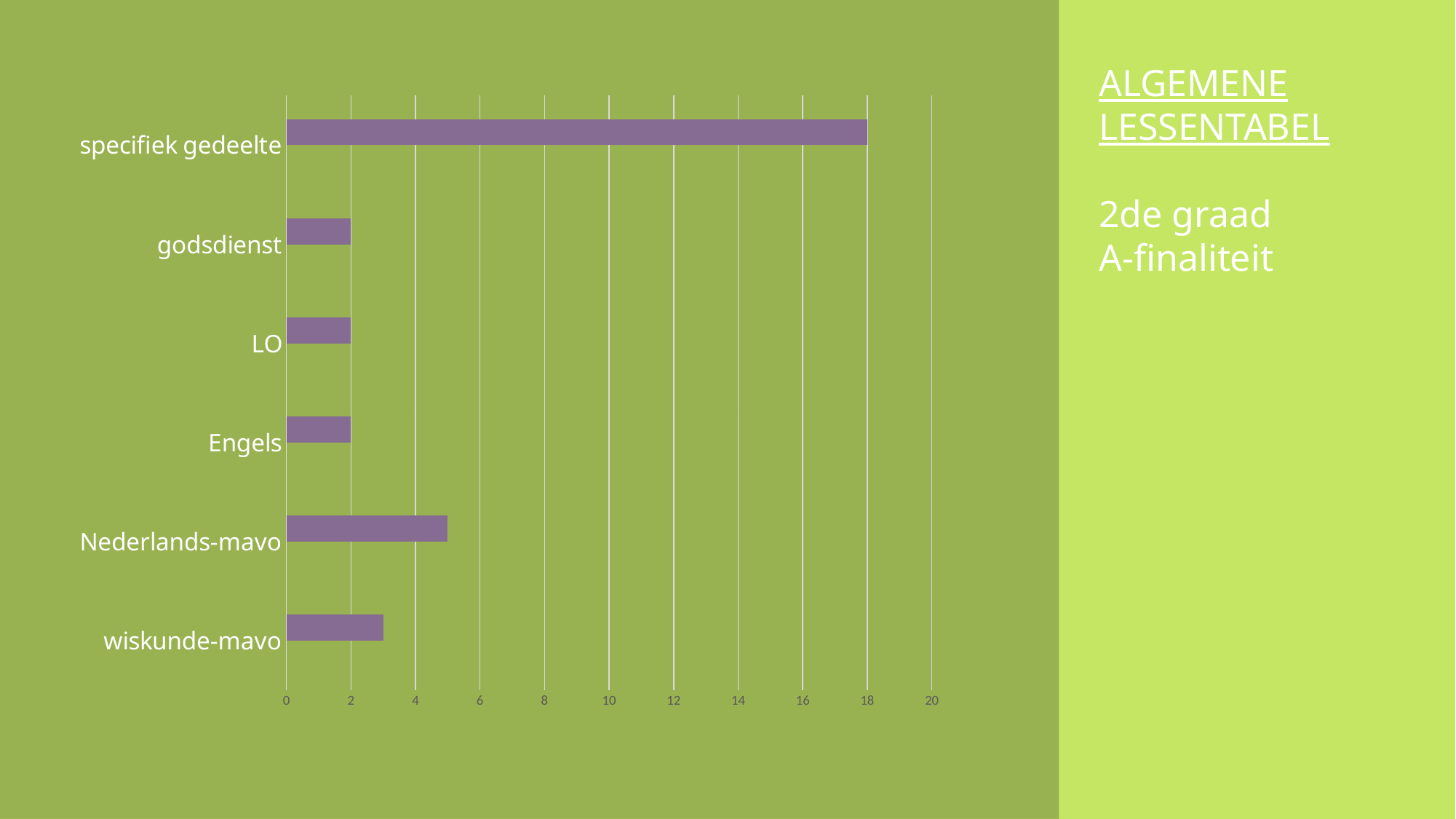
What is the value for Engels? 2 What is the value for LO? 2 What is the difference between the values for specifiek gedeelte and Engels? 16 Which is larger, the value for Nederlands-mavo or the value for wiskunde-mavo? Nederlands-mavo What is the highest tick value shown on the horizontal axis? 20 What is the value for specifiek gedeelte? 18 How many categories are plotted in the chart? 6 Is the value for Nederlands-mavo greater or less than 4? greater Which category has the highest value in the chart? specifiek gedeelte Is the value for wiskunde-mavo greater or less than 4? less What is the value for godsdienst? 2 What kind of chart is shown on the slide? bar chart